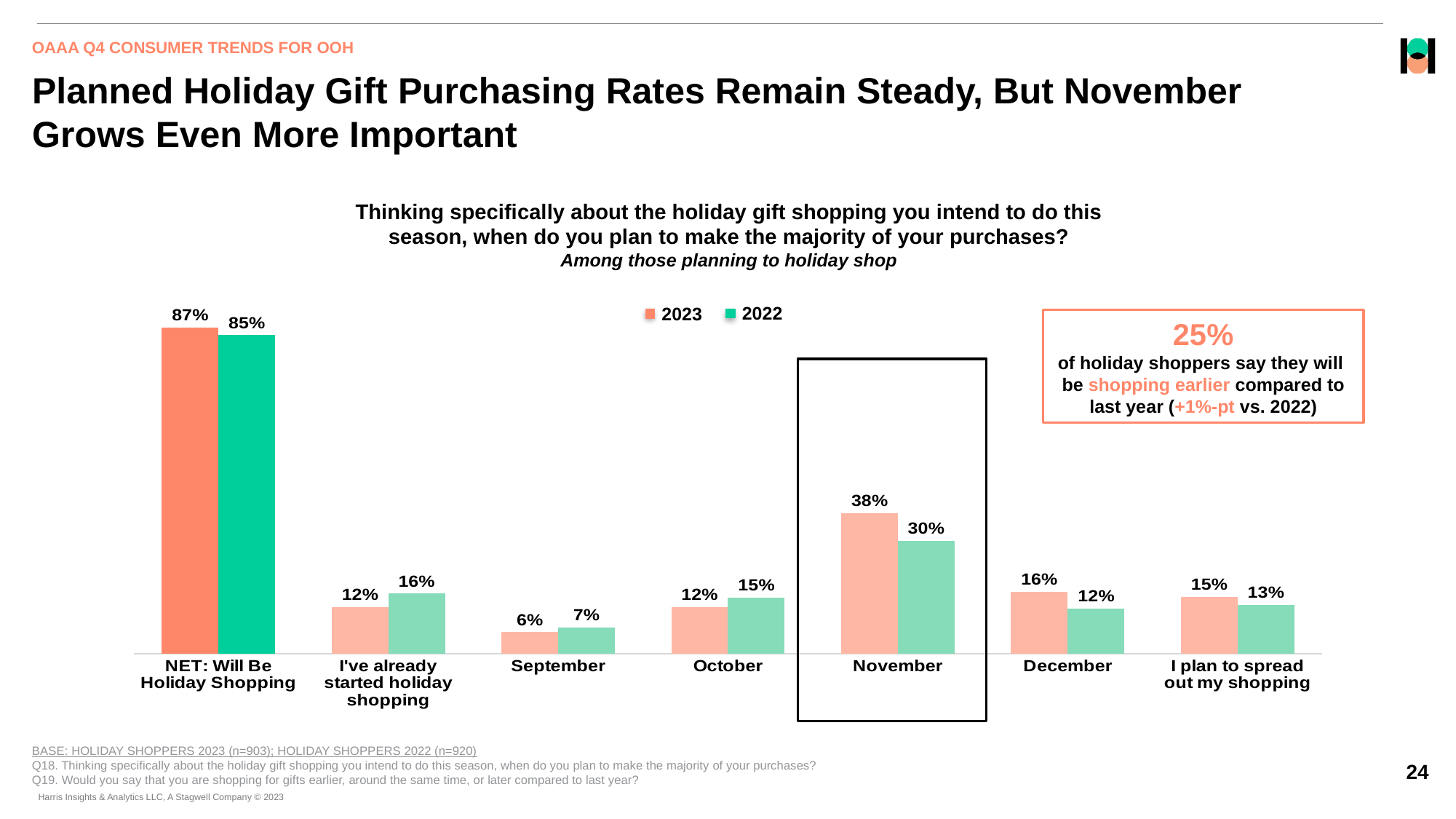
How many series does the legend list? 2 What is the 2022 value for 'I've already started holiday shopping'? 16% What is the difference between the 2023 and 2022 values for November? 8% What is the difference between the 2023 and 2022 values for December? 4% Excluding the NET category, which month or option has the highest 2023 value? November What kind of chart is shown on the slide? Bar chart How many categories are shown on the x axis? 7 Which series is shown in orange in the legend? 2023 What is the 2023 value for November? 38% Which is larger for October, the 2023 value or the 2022 value? 2022 Which category has the lowest 2022 value? September What is the 2023 value for 'NET: Will Be Holiday Shopping'? 87%